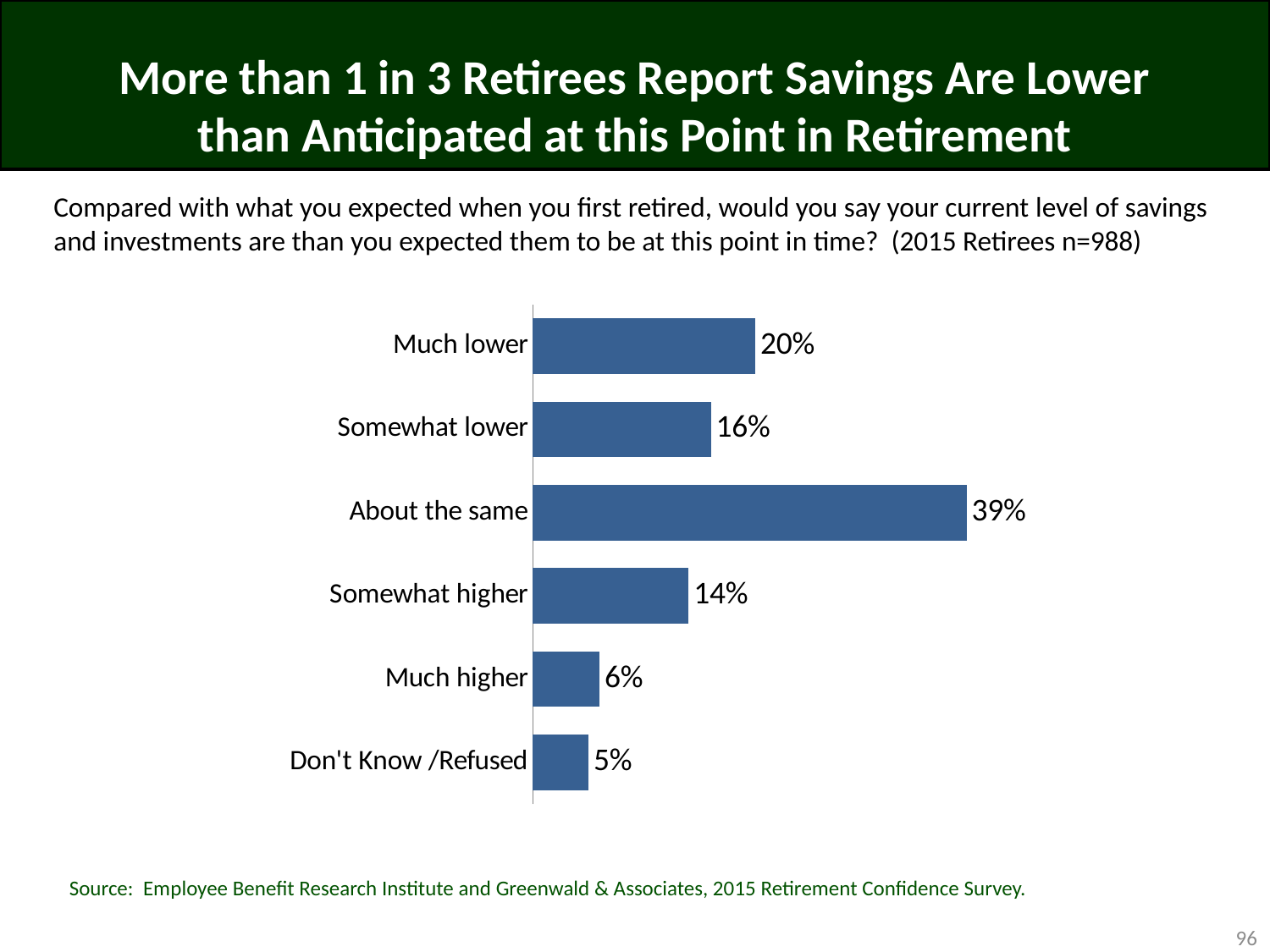
What percentage is shown for "Don't Know /Refused"? 5% What value is shown for "Much higher"? 6% What value is shown for "Somewhat lower"? 16% Which category has the highest value? About the same What percentage of retirees said their savings are about the same as expected? 39% What is the combined value of "Much lower" and "Somewhat lower"? 36% What type of chart is shown on the slide? Bar chart What is the difference between the "Much lower" and "Somewhat lower" values? 4% How many categories are shown in the chart? 6 What percentage of retirees said their savings are much lower than expected? 20% Which is larger, the value for "Somewhat higher" or the value for "Much higher"? Somewhat higher Which category has the lowest value? Don't Know /Refused